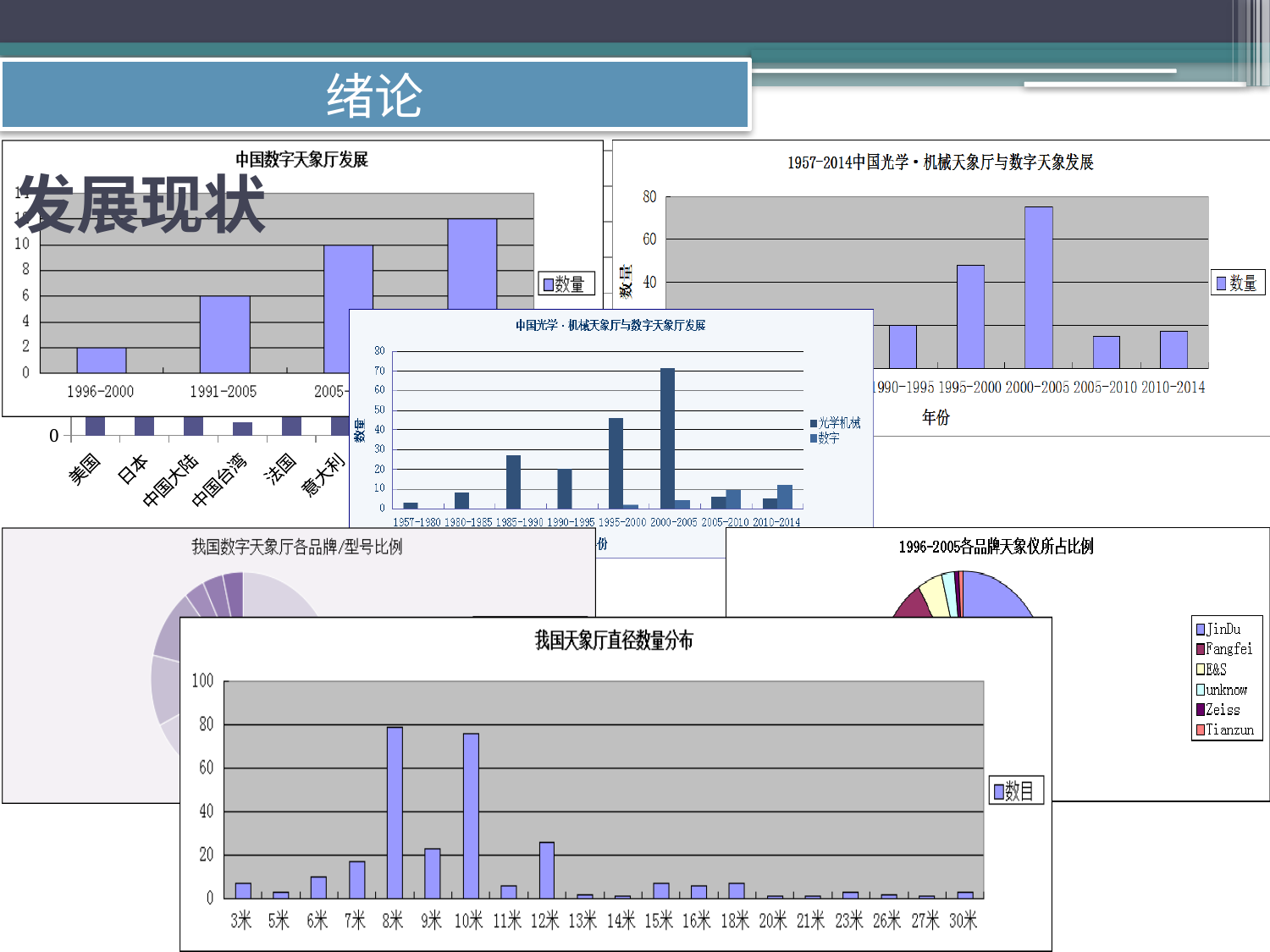
How many diameter categories are shown on the x axis of '我国天象厅直径数量分布'? 20 In '我国天象厅直径数量分布', is the value for 12米 greater or less than 40? less In '我国天象厅直径数量分布', which is larger, the value for 8米 or the value for 12米? 8米 What kind of chart is '我国天象厅直径数量分布'? bar chart In '中国光学·机械天象厅与数字天象厅发展' (middle chart), is the 光学机械 value for 1995-2000 greater or less than 40? greater How many series does the legend list in '中国光学·机械天象厅与数字天象厅发展' (the chart in the middle of the slide)? 2 In '中国数字天象厅发展' (top-left chart), what is the value for 1996-2000? 2 In '1957-2014中国光学·机械天象厅与数字天象发展' (top-right chart), which period has the highest value? 2000-2005 In '中国光学·机械天象厅与数字天象厅发展' (middle chart), which period has the highest 光学机械 value? 2000-2005 What legend entry is shown for '我国天象厅直径数量分布'? 数目 How many legend entries does the pie chart '1996-2005各品牌天象仪所占比例' list? 6 In '我国天象厅直径数量分布', is the value for 8米 greater or less than 60? greater